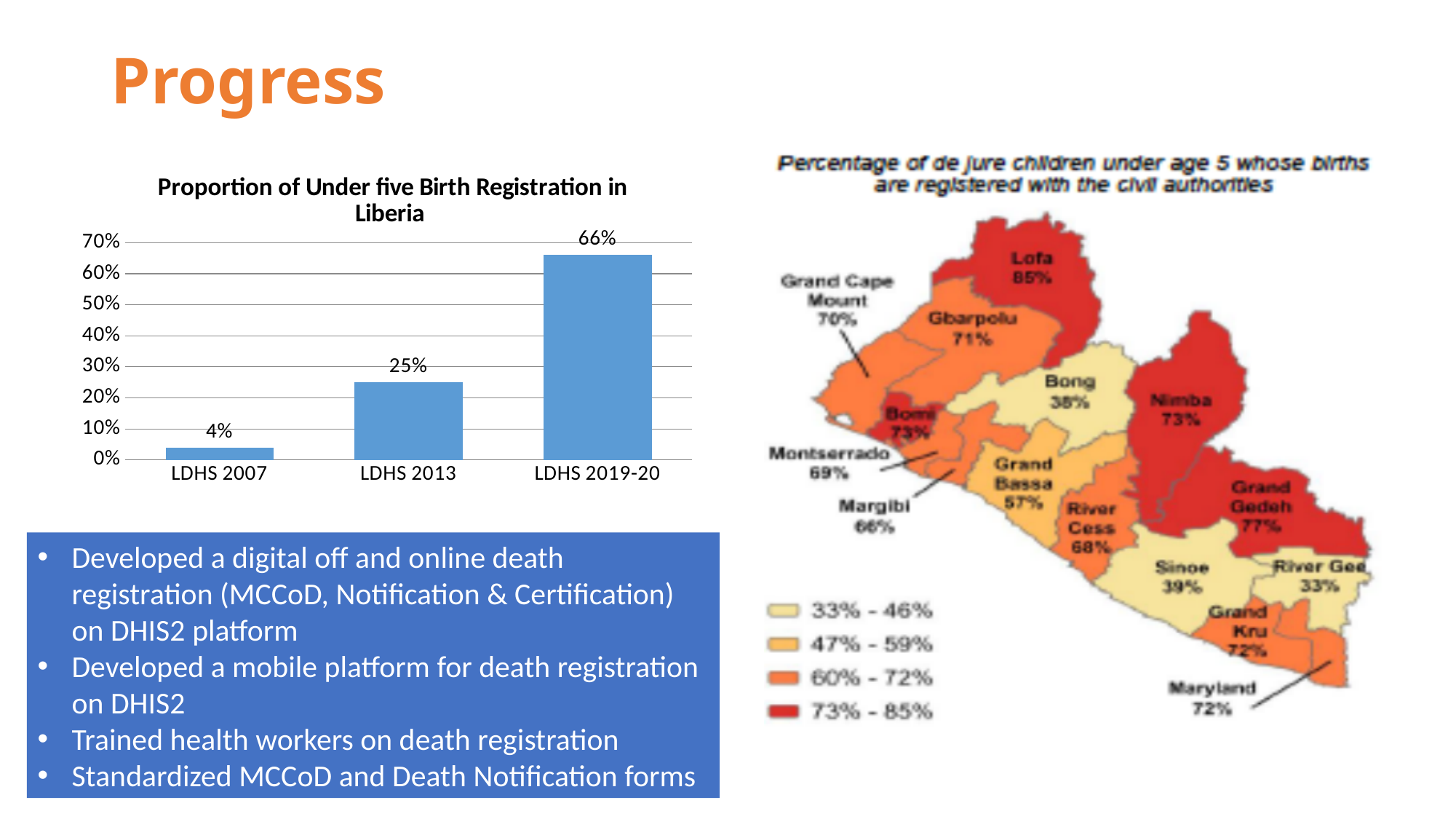
What type of chart is the 'Proportion of Under five Birth Registration in Liberia' chart? bar chart In the bar chart 'Proportion of Under five Birth Registration in Liberia', do the values rise or fall from LDHS 2007 to LDHS 2019-20? rise In the bar chart 'Proportion of Under five Birth Registration in Liberia', which survey has the highest value? LDHS 2019-20 In the map on the right, which county has the lowest percentage shown? River Gee In the bar chart 'Proportion of Under five Birth Registration in Liberia', what is the value for LDHS 2013? 25% In the bar chart 'Proportion of Under five Birth Registration in Liberia', what is the value for LDHS 2019-20? 66% In the bar chart 'Proportion of Under five Birth Registration in Liberia', what is the difference between the LDHS 2019-20 and LDHS 2007 values? 62% In the map on the right, what percentage is shown for Lofa? 85% In the bar chart 'Proportion of Under five Birth Registration in Liberia', what is the highest value shown on the y axis? 70% In the bar chart 'Proportion of Under five Birth Registration in Liberia', how many categories are shown on the x axis? 3 In the bar chart 'Proportion of Under five Birth Registration in Liberia', which survey has the lowest value? LDHS 2007 In the map on the right, which is larger, the value for Nimba or the value for Bong? Nimba